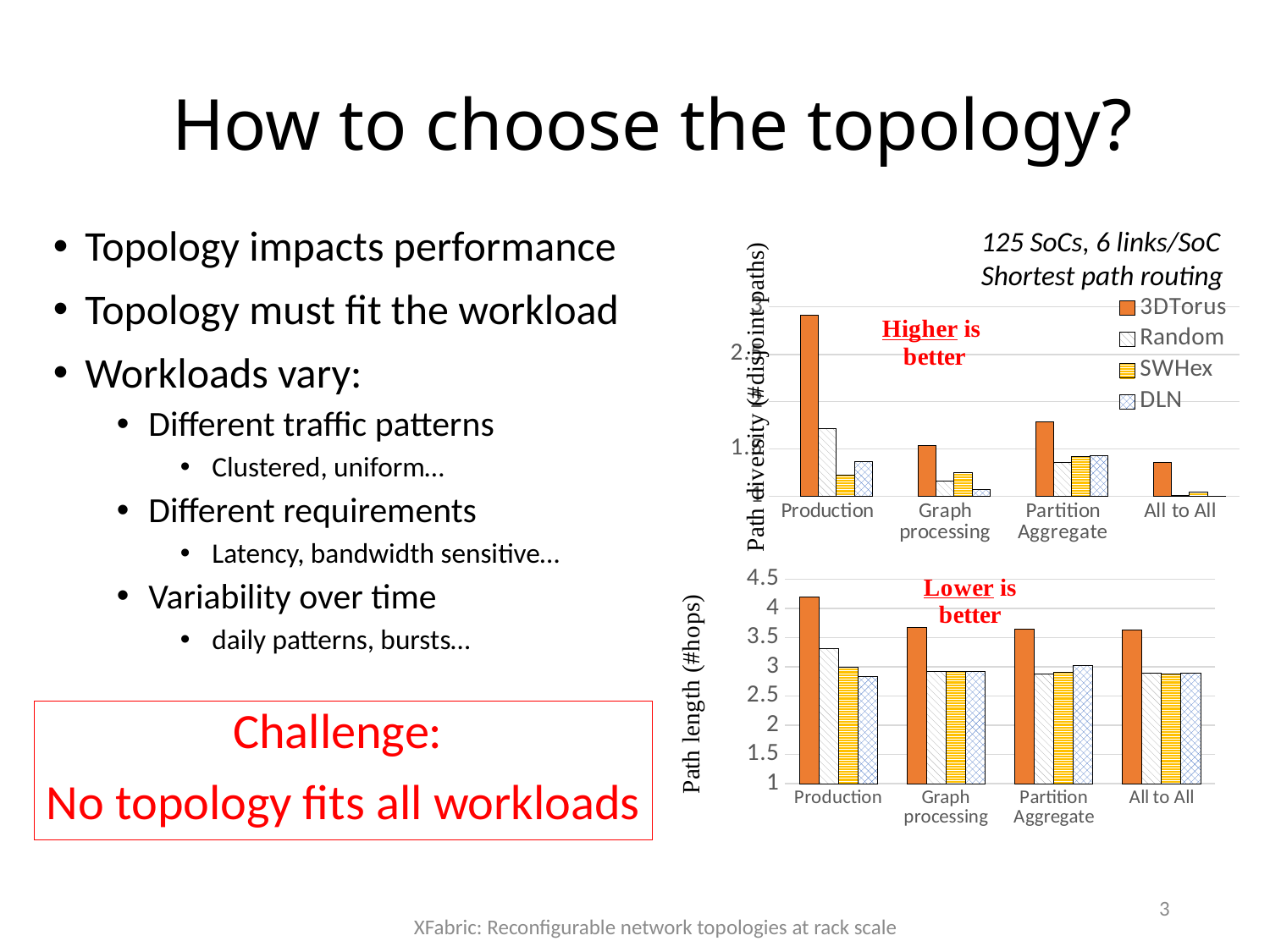
In the bottom chart (Path length), is the DLN value for Production greater or less than 3? less How many series does the legend of the top chart list? 4 In the bottom chart (Path length), is the 3DTorus value for Production greater or less than 4? greater In the top chart (Path diversity), for which category is the 3DTorus value highest? Production In the bottom chart (Path length), which series has the lowest value for Production? DLN In the bottom chart (Path length), which is larger for Production: 3DTorus or Random? 3DTorus In the top chart (Path diversity), which series has the highest value for Production? 3DTorus What kind of chart is the top chart (Path diversity)? bar chart How many categories are shown on the x axis of the bottom chart (Path length)? 4 In the bottom chart (Path length), is the 3DTorus value for Graph processing greater or less than 3.5? greater In the top chart (Path diversity), which is larger for Production: Random or SWHex? Random What are the legend entries of the top chart? 3DTorus, Random, SWHex, DLN